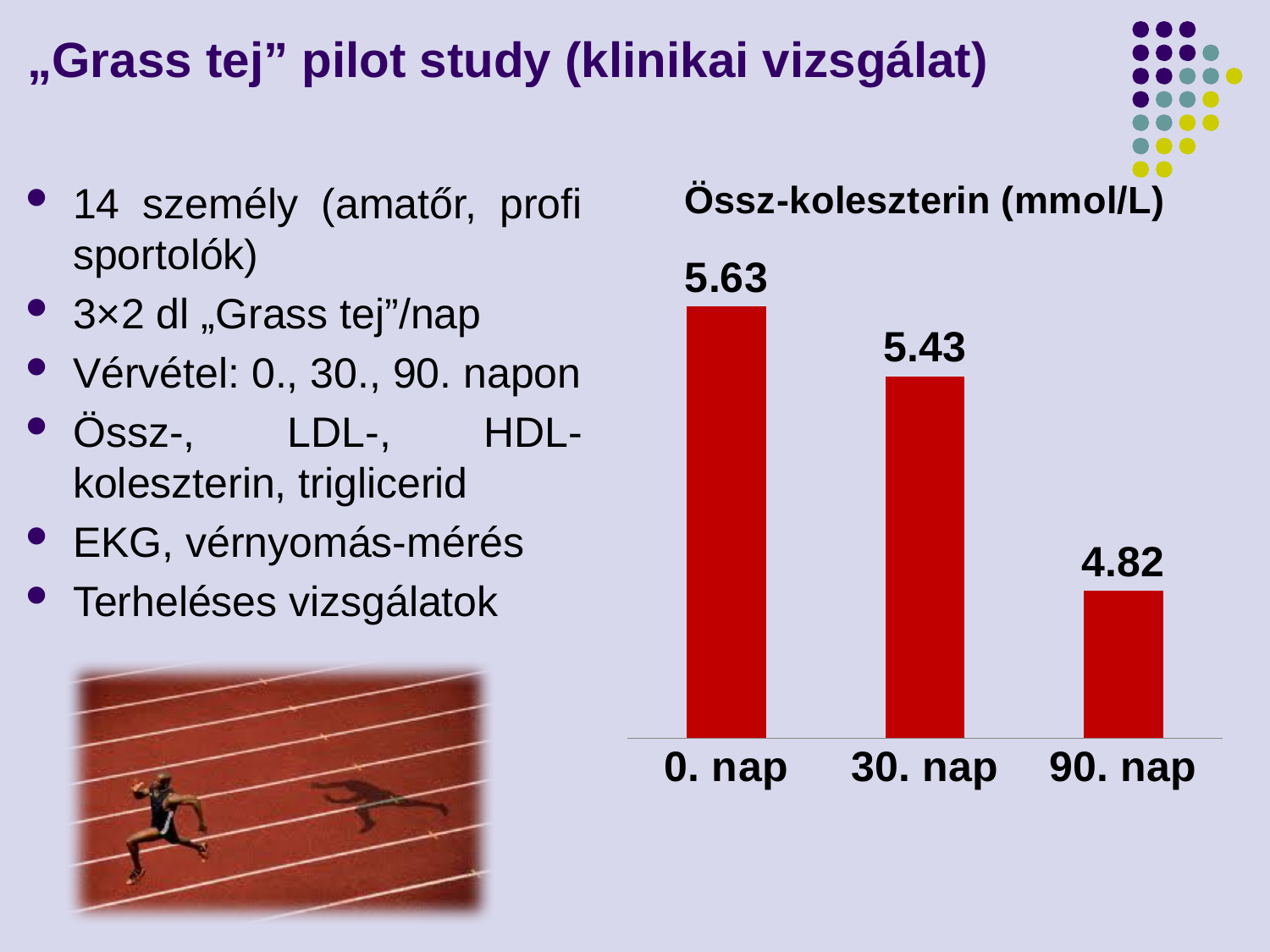
Which is larger in the Össz-koleszterin (mmol/L) chart: the value for 30. nap or the value for 90. nap? 30. nap How many categories are shown in the Össz-koleszterin (mmol/L) chart? 3 Do the values in the Össz-koleszterin (mmol/L) chart rise or fall from 0. nap to 90. nap? fall What kind of chart is the Össz-koleszterin (mmol/L) chart? bar chart Which category has the lowest value in the Össz-koleszterin (mmol/L) chart? 90. nap What is the value for 90. nap in the Össz-koleszterin (mmol/L) chart? 4.82 Which category has the highest value in the Össz-koleszterin (mmol/L) chart? 0. nap What is the value for 30. nap in the Össz-koleszterin (mmol/L) chart? 5.43 What is the difference between the values for 0. nap and 30. nap in the Össz-koleszterin (mmol/L) chart? 0.20 What is the value for 0. nap in the Össz-koleszterin (mmol/L) chart? 5.63 What is the difference between the values for 0. nap and 90. nap in the Össz-koleszterin (mmol/L) chart? 0.81 What is the title of the chart on the slide? Össz-koleszterin (mmol/L)